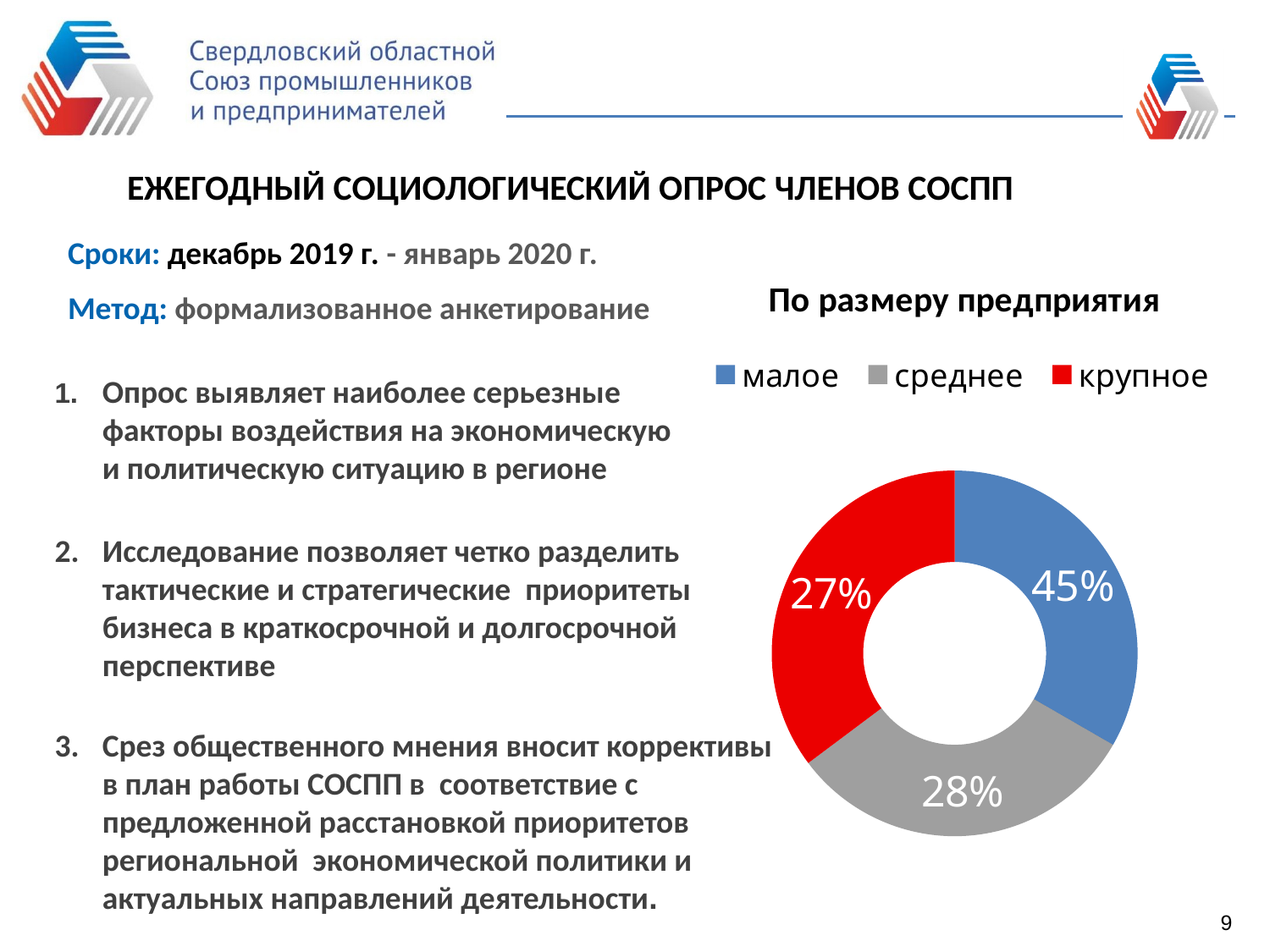
Which category has the largest share in the chart 'По размеру предприятия'? малое Which category has the smallest share in the chart 'По размеру предприятия'? крупное In the chart 'По размеру предприятия', which is larger: the share of 'малое' or the share of 'среднее'? малое In the chart 'По размеру предприятия', what is the difference between the shares of 'малое' and 'крупное'? 18% What share of the chart 'По размеру предприятия' is 'крупное'? 27% What kind of chart is 'По размеру предприятия'? Doughnut (pie) chart What share of the chart 'По размеру предприятия' is 'среднее'? 28% What is the title of the chart on the slide? По размеру предприятия In the chart 'По размеру предприятия', which colour represents 'крупное'? Red In the chart 'По размеру предприятия', what is the difference between the shares of 'среднее' and 'крупное'? 1% How many categories does the chart 'По размеру предприятия' show? 3 What share of the chart 'По размеру предприятия' is 'малое'? 45%